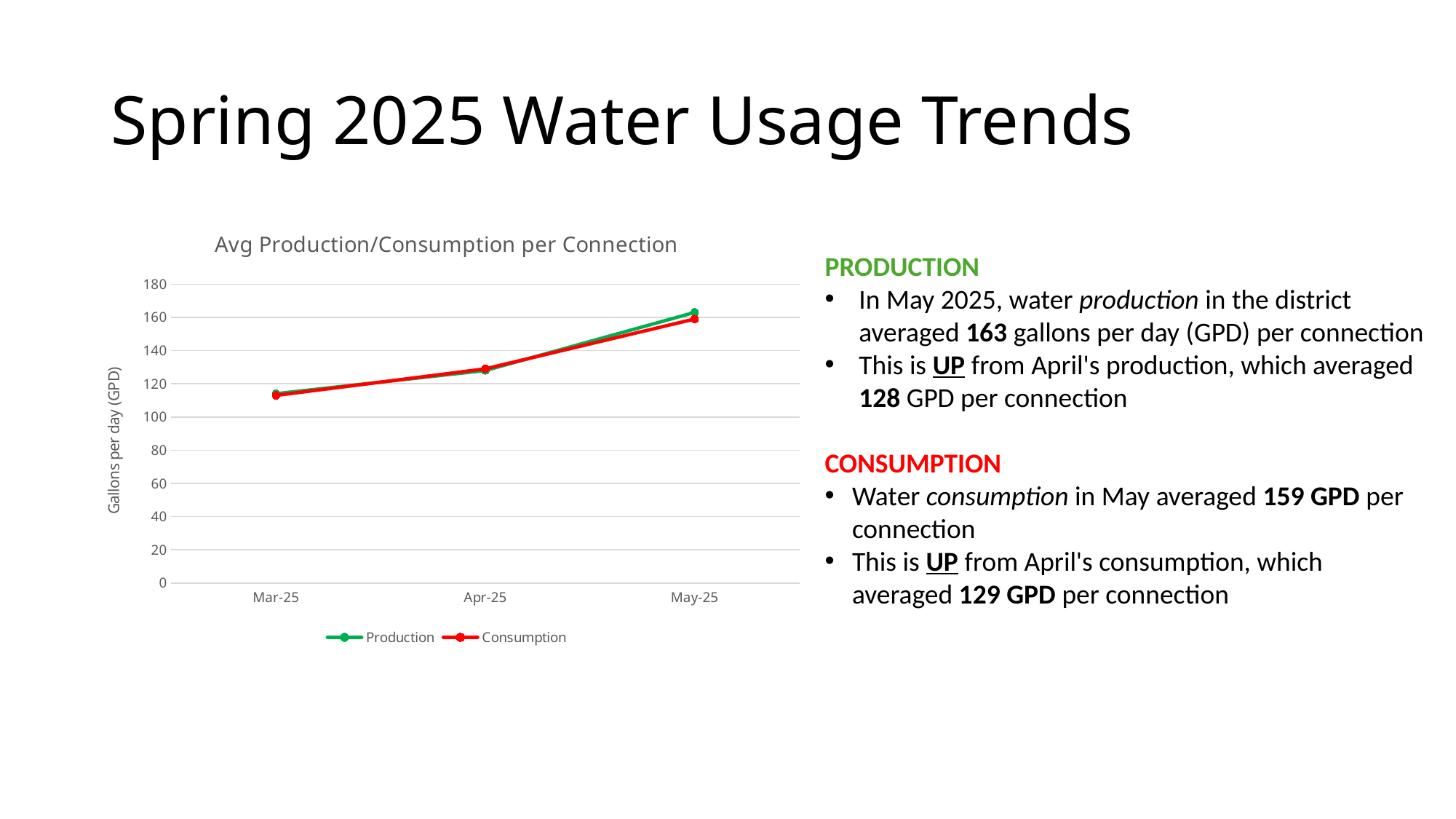
How many series does the chart legend list? 2 What kind of chart is shown on the slide? line chart What is the Production value for Apr-25? 128 Is the Production value for Mar-25 greater or less than 120? less How many months are plotted on the x axis of the chart? 3 What is the Consumption value for Apr-25? 129 By how much did Production increase from Apr-25 to May-25? 35 What is the title of the chart? Avg Production/Consumption per Connection Do the Production values rise or fall from Mar-25 to May-25? rise What is the Production value for May-25? 163 What is the Consumption value for May-25? 159 Which month has the highest Consumption value? May-25